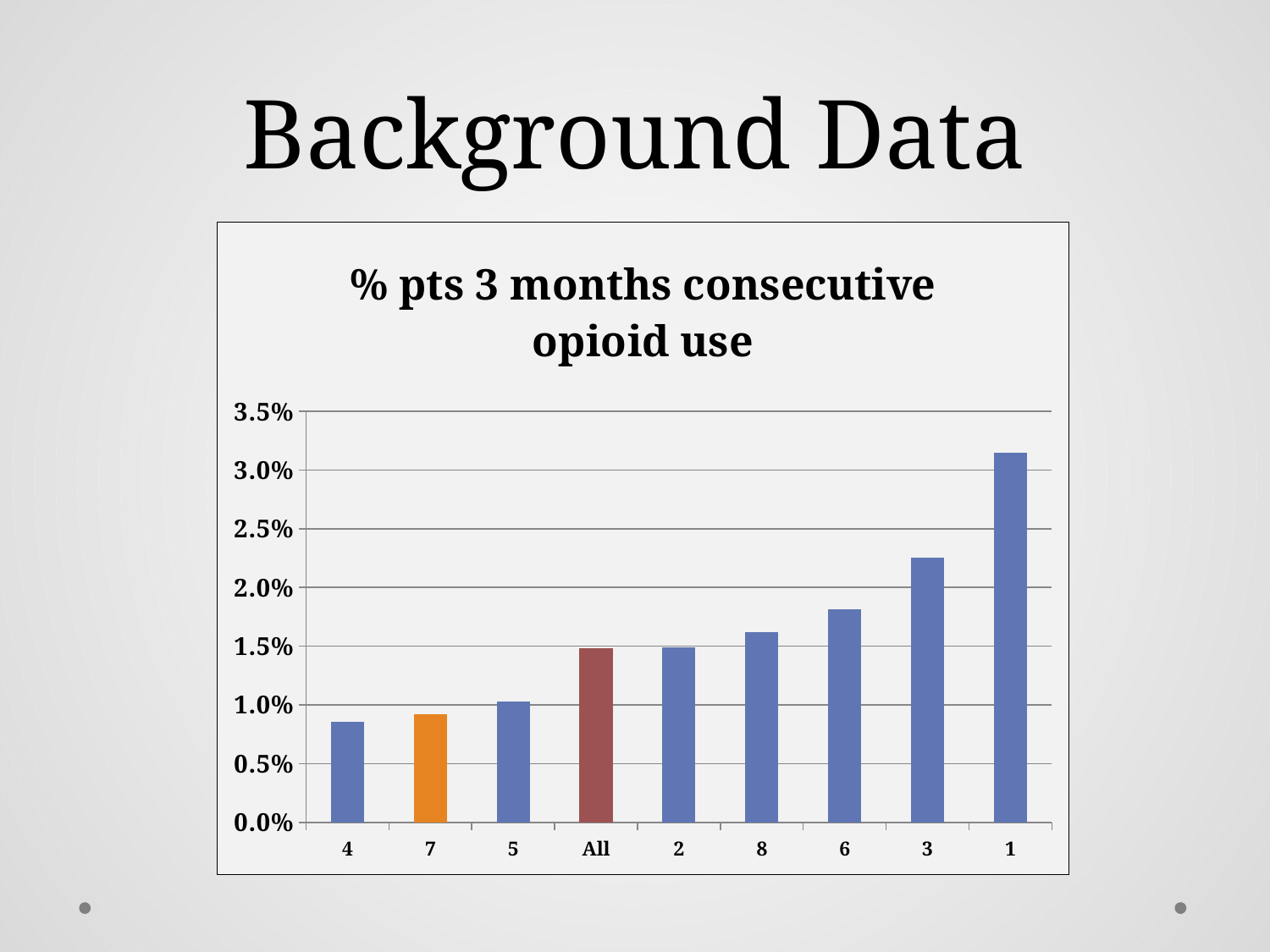
Is the value for category 8 greater or less than 1.5%? greater How many categories are plotted on the x axis? 9 Which category has the lowest value? 4 Is the value for category 1 greater or less than 3.0%? greater What kind of chart is shown on the slide? bar chart What is the title of the chart? % pts 3 months consecutive opioid use Which has the larger value, category 3 or category 6? 3 Is the value for category 6 greater or less than 2.0%? less Which category has the highest value? 1 Do the values rise or fall moving from left to right along the x axis? rise